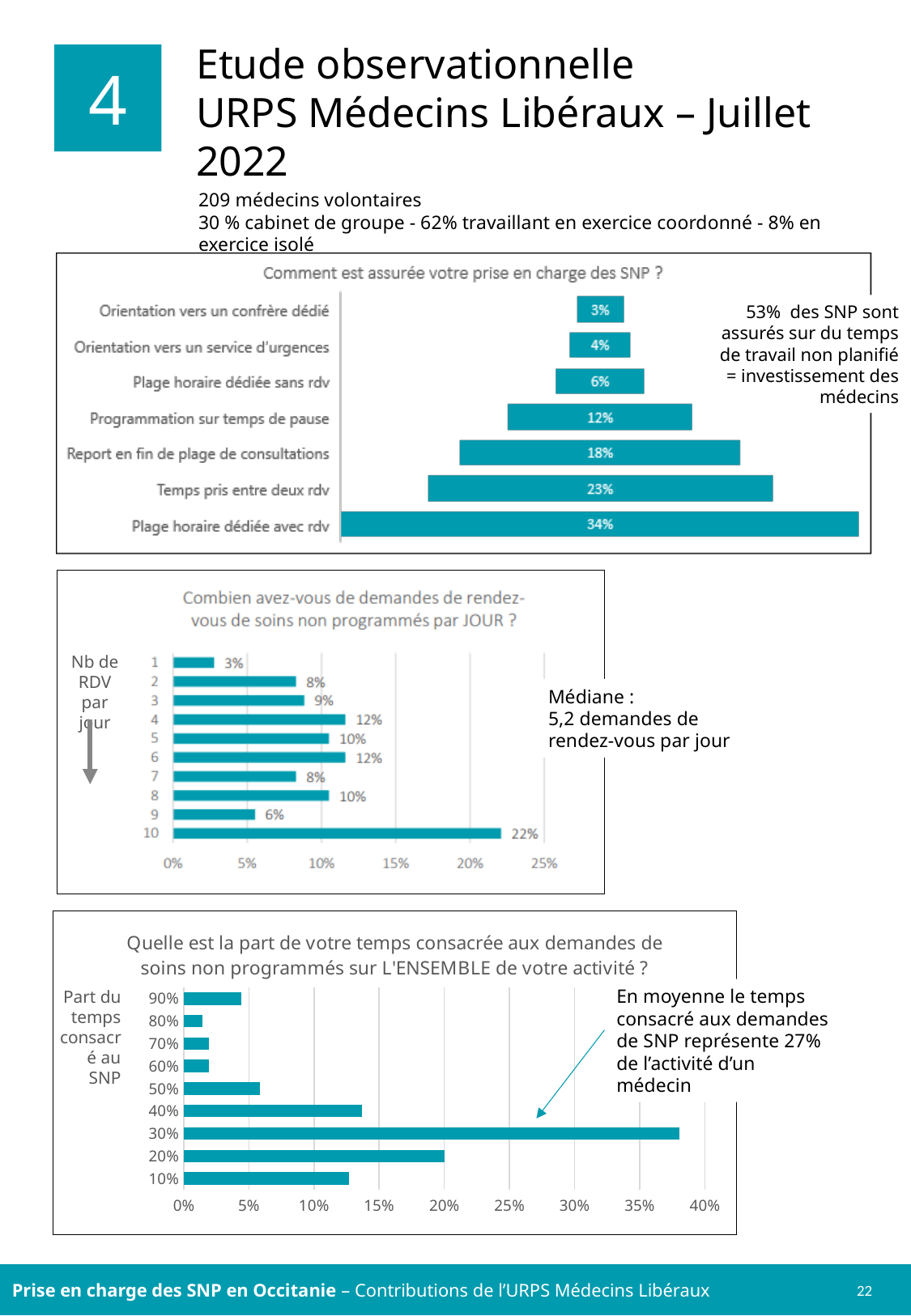
What type of chart is the bottom chart 'Quelle est la part de votre temps consacrée aux demandes de soins non programmés...'? bar chart In the bottom chart 'Quelle est la part de votre temps consacrée aux demandes de soins non programmés...', is the value for the 30% category greater or less than 35%? greater In the chart 'Comment est assurée votre prise en charge des SNP ?', what is the value for 'Plage horaire dédiée avec rdv'? 34% How many categories are shown in the chart 'Combien avez-vous de demandes de rendez-vous de soins non programmés par JOUR ?'? 10 In the chart 'Combien avez-vous de demandes de rendez-vous de soins non programmés par JOUR ?', what is the value for 10 requests per day? 22% In the chart 'Combien avez-vous de demandes de rendez-vous de soins non programmés par JOUR ?', which category has the highest value? 10 How many categories are shown in the chart 'Comment est assurée votre prise en charge des SNP ?'? 7 In the chart 'Combien avez-vous de demandes de rendez-vous de soins non programmés par JOUR ?', which is larger: the value for 3 or the value for 9? 3 In the chart 'Comment est assurée votre prise en charge des SNP ?', what is the value for 'Report en fin de plage de consultations'? 18% In the chart 'Comment est assurée votre prise en charge des SNP ?', which category has the lowest value? Orientation vers un confrère dédié In the chart 'Comment est assurée votre prise en charge des SNP ?', what is the difference between 'Temps pris entre deux rdv' and 'Programmation sur temps de pause'? 11% In the chart 'Combien avez-vous de demandes de rendez-vous de soins non programmés par JOUR ?', what is the value for 5 requests per day? 10%